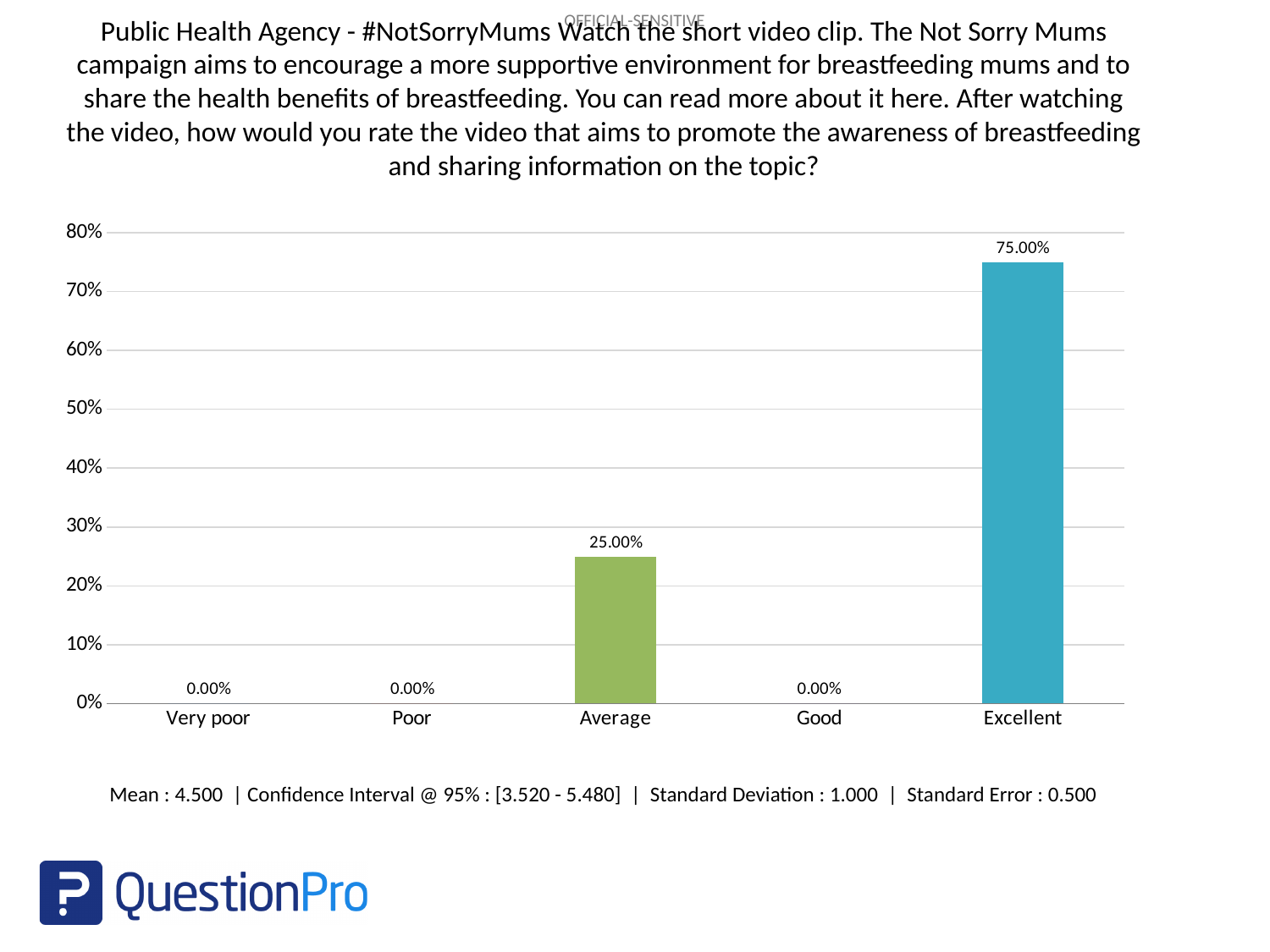
Is the value for Average greater or less than 30%? less What is the value for Very poor? 0.00% What is the difference between the values for Excellent and Average? 50.00% What is the value for Excellent? 75.00% Which category has the highest value? Excellent Is the value for Excellent greater or less than 70%? greater How many categories are shown on the x axis? 5 What kind of chart is shown on the slide? bar chart What is the value for Good? 0.00% Which is larger, the value for Average or the value for Excellent? Excellent What mean value is reported below the chart? 4.500 What is the value for Average? 25.00%